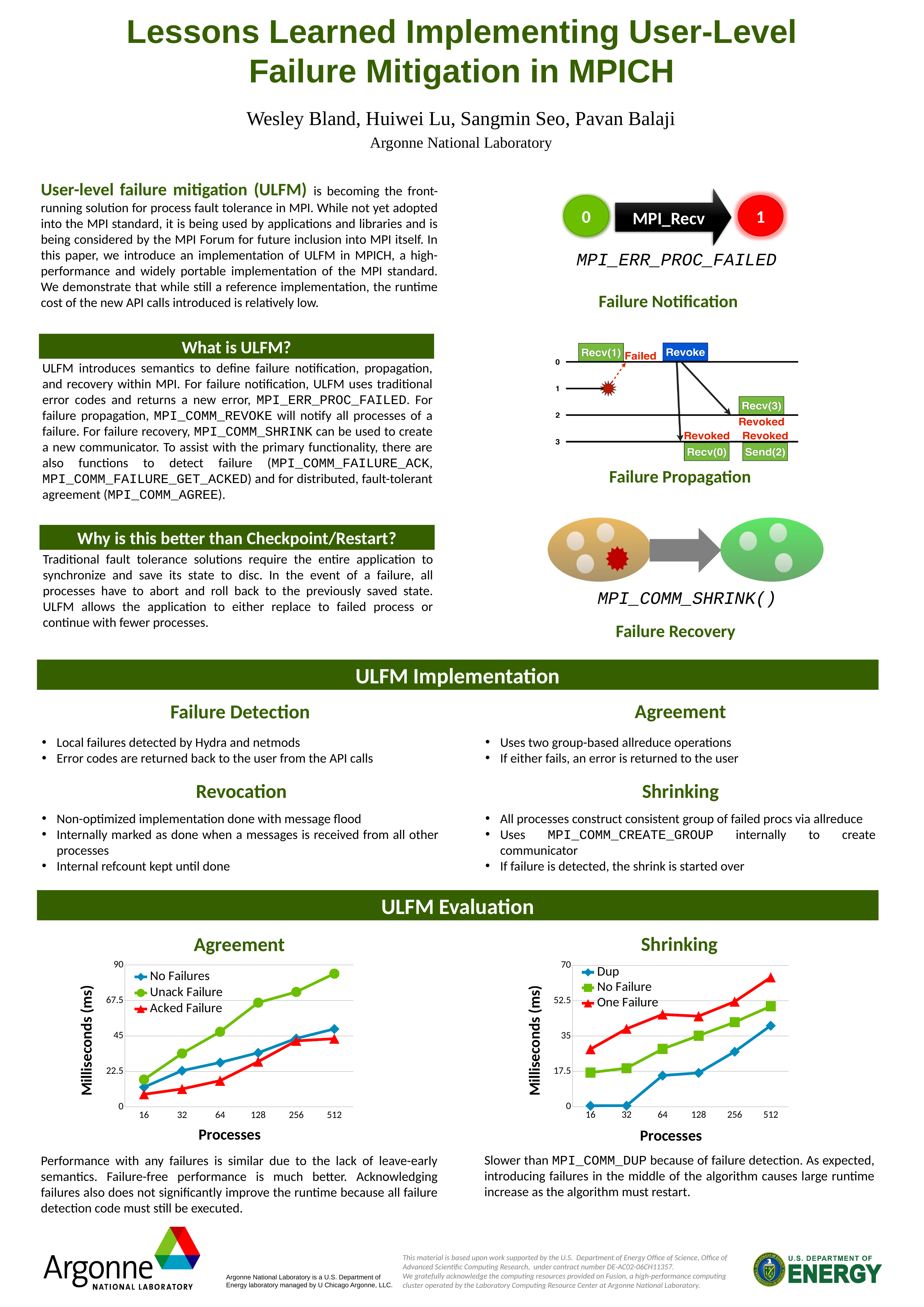
In the Agreement chart, which series has the highest value at 512 processes? Unack Failure What is the y-axis label of the Shrinking chart? Milliseconds (ms) How many series does the legend of the Shrinking chart list? 3 In the Shrinking chart, which series has the lowest value at 16 processes? Dup In the Agreement chart, does the Unack Failure series rise or fall as the number of processes increases? rise In the Agreement chart, is the value for Unack Failure at 512 processes greater or less than 67.5? greater In the Shrinking chart, at 64 processes, which is larger: One Failure or Dup? One Failure In the Agreement chart, is the value for No Failures at 16 processes greater or less than 22.5? less How many process counts are plotted along the x axis of the Agreement chart? 6 What type of chart is the Agreement chart? line chart In the Shrinking chart, is the value for One Failure at 512 processes greater or less than 52.5? greater